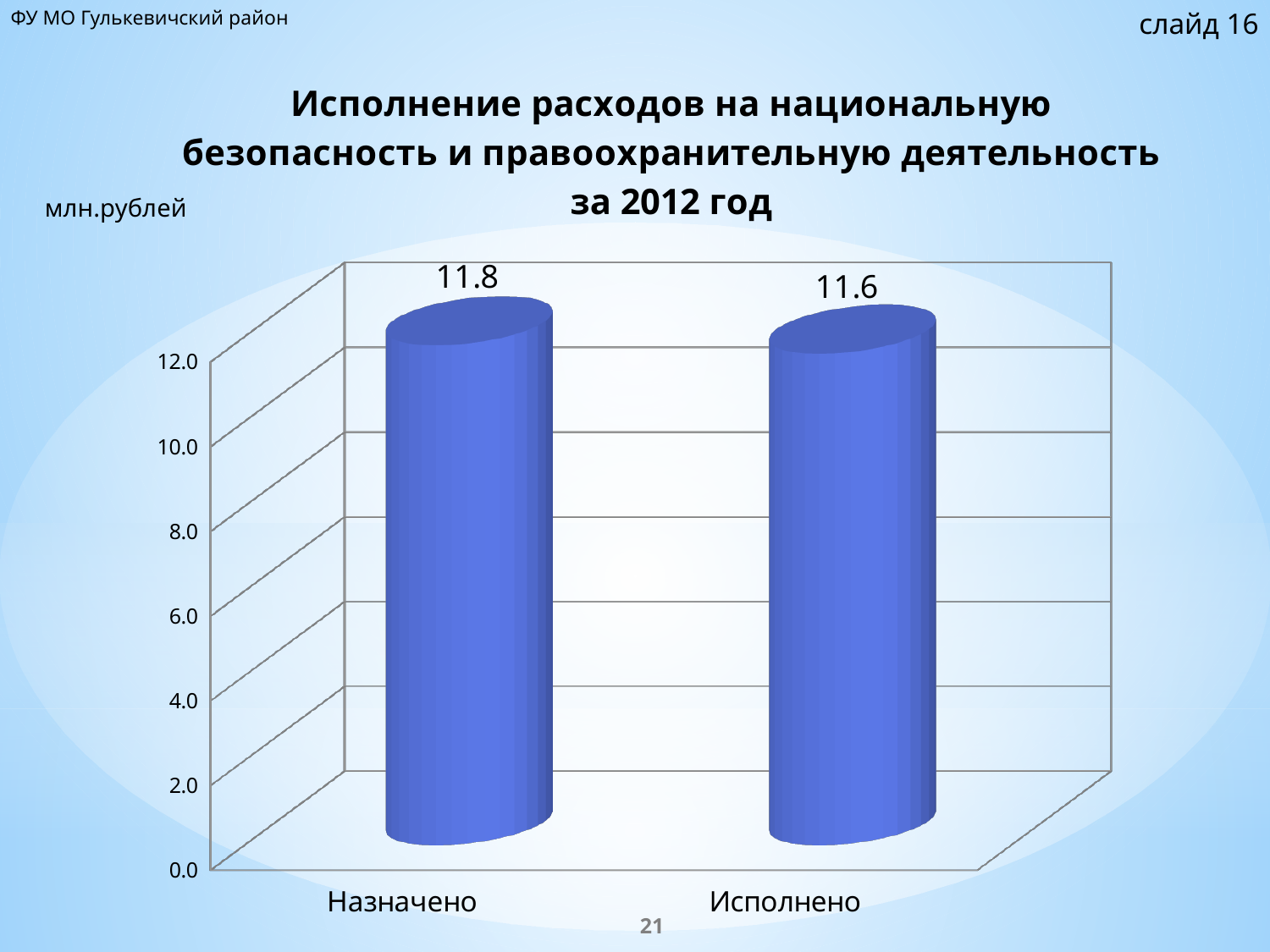
What is the value for Назначено? 11.8 Is the value for Исполнено greater or less than 10.0? greater What is the value for Исполнено? 11.6 Which category has the higher value? Назначено What year does the chart title refer to? 2012 What unit is indicated for the values on the chart? млн.рублей Which category has the lower value? Исполнено How many categories are shown on the chart? 2 What kind of chart is shown on the slide? bar chart Is the value for Назначено larger or smaller than the value for Исполнено? larger What is the difference between the values for Назначено and Исполнено? 0.2